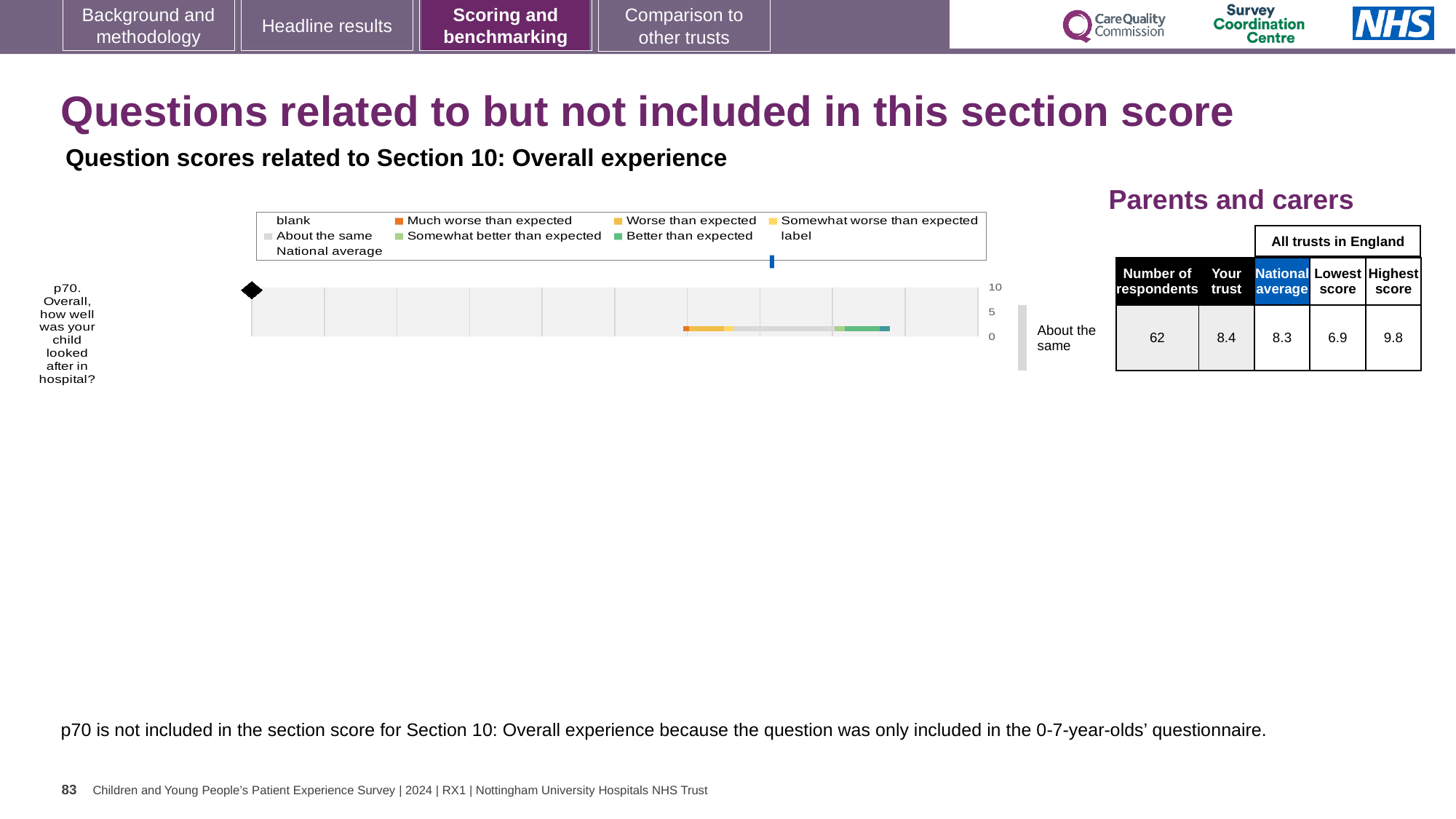
In the table beside the chart, what is the highest score among all trusts in England for p70? 9.8 In the table beside the chart, what is the lowest score among all trusts in England for p70? 6.9 For p70, what is the difference between the highest score and the lowest score among all trusts in England? 2.9 In the table beside the chart, what is the national average score for p70? 8.3 In the table beside the chart, what is the 'Your trust' score for p70? 8.4 In the table beside the chart, how many respondents answered p70? 62 How many entries does the chart legend list? 9 For p70, which is larger: the 'Your trust' score or the national average? Your trust Which benchmark category is shown next to the bar for p70? About the same What kind of chart is used to show the p70 question score? bar chart What colour does the legend use for 'Much worse than expected'? orange How many questions are plotted in the chart? 1